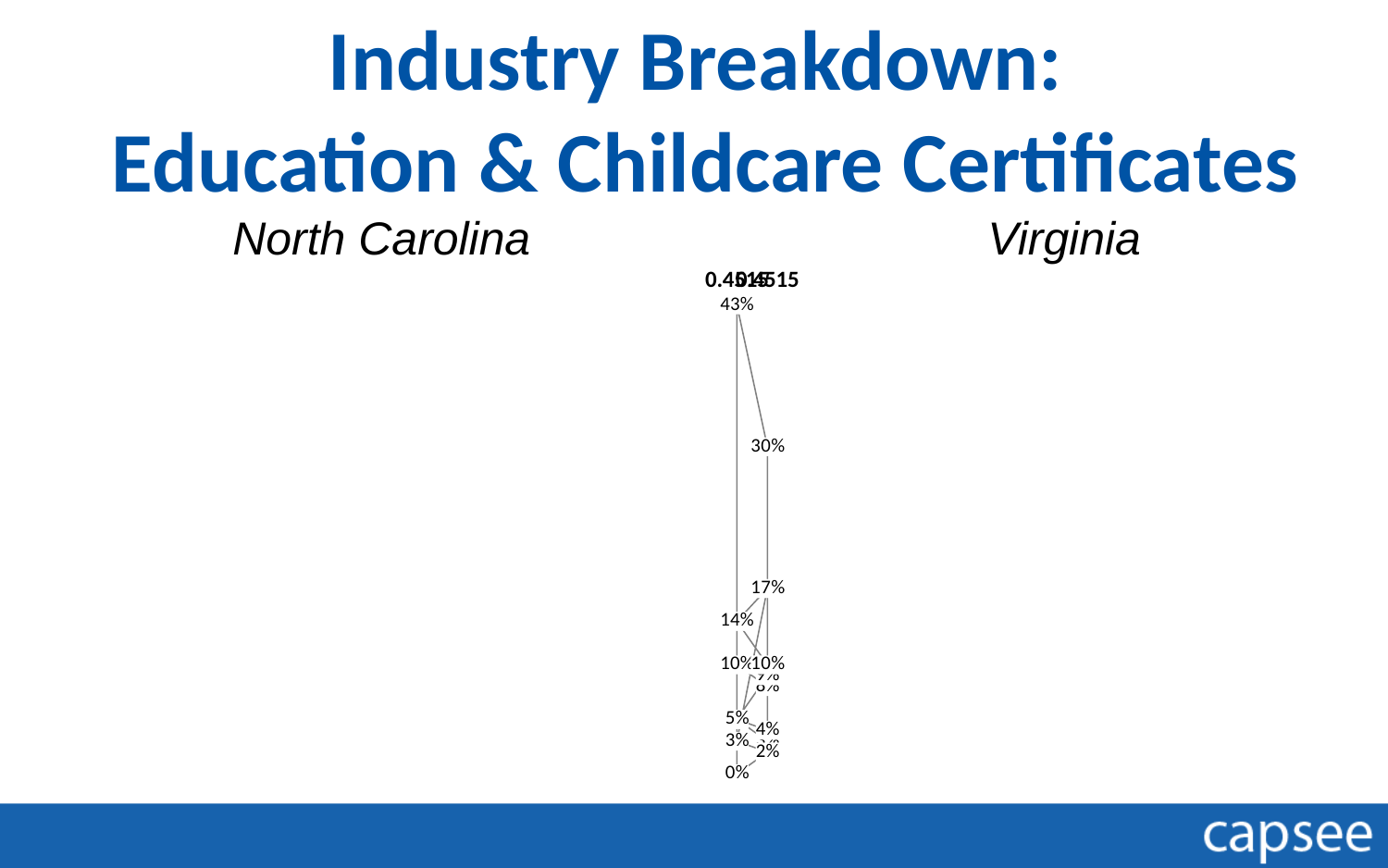
Is the highest data label on the chart (43%) greater or less than 40%? greater What is the title shown at the top of the slide above the chart? Industry Breakdown: Education & Childcare Certificates Which two states are named as labels above the chart area? North Carolina and Virginia What is the highest percentage data label visible on the chart? 43% What is the lowest percentage data label visible on the chart? 0% What is the difference between the two largest data labels shown on the chart, 43% and 30%? 13% Which is larger among the data labels shown on the chart, 43% or 30%? 43%